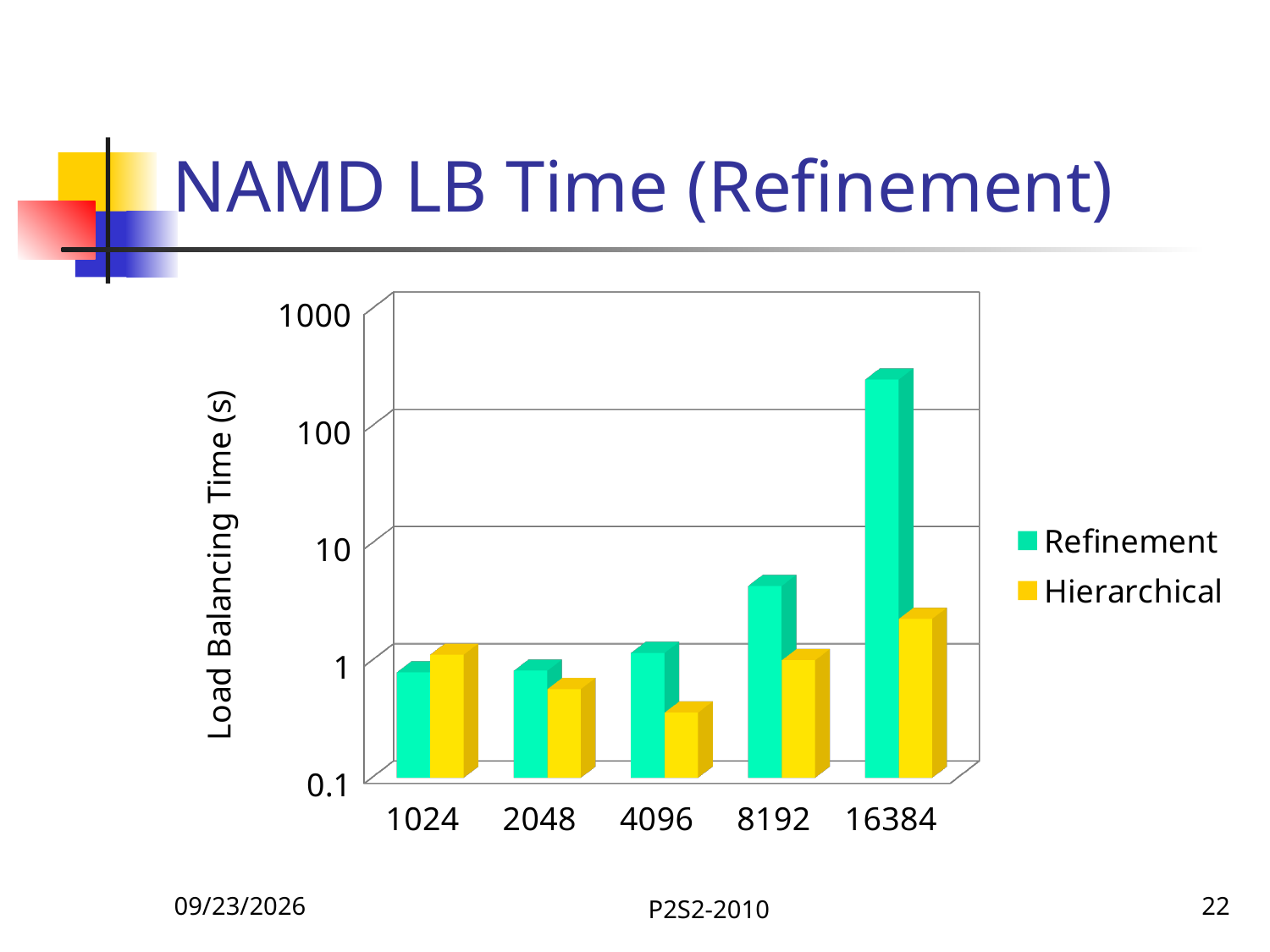
How many series does the legend list? 2 How many categories are shown on the x axis? 5 Do the Refinement values generally rise or fall as the x-axis values increase? rise At 16384, which series has the larger value, Refinement or Hierarchical? Refinement Which series is shown in yellow? Hierarchical At which category is the Refinement value highest? 16384 Is the Refinement value for 8192 greater or less than 10? less What is the label of the y axis? Load Balancing Time (s) Is the Hierarchical value for 4096 greater or less than 1? less At which category is the Hierarchical value lowest? 4096 What kind of chart is shown on the slide? bar chart Is the Refinement value for 16384 greater or less than 100? greater